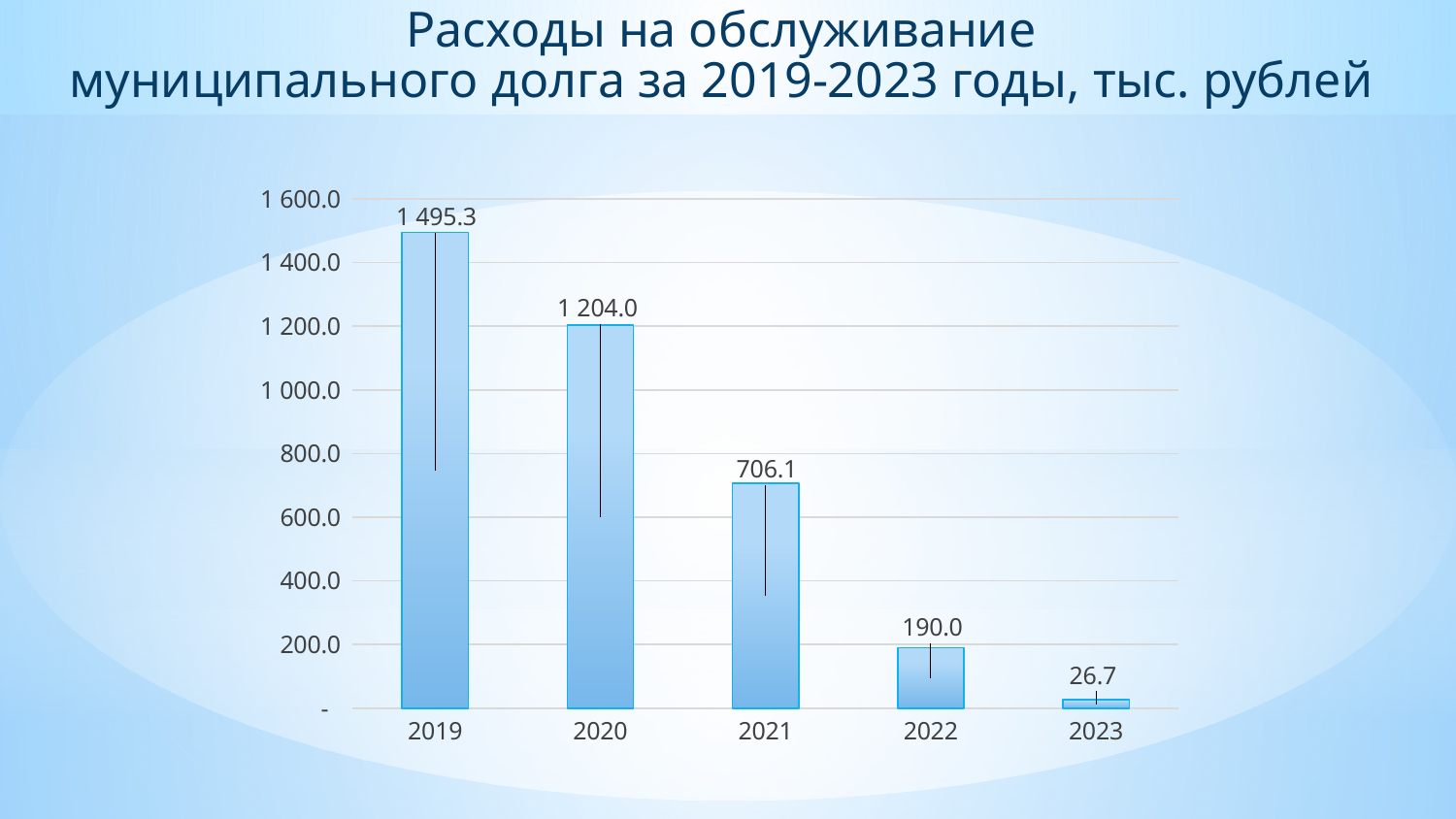
What is the value for 2021? 706.1 Which year has the lowest value? 2023 What kind of chart is shown on the slide? bar chart What is the difference between the values for 2019 and 2020? 291.3 What is the difference between the values for 2022 and 2023? 163.3 Which year has the highest value? 2019 Do the values rise or fall from 2019 to 2023? fall How many years are shown on the x axis? 5 What is the value for 2019? 1 495.3 Which is larger, the value for 2020 or the value for 2021? 2020 What is the value for 2023? 26.7 Is the value for 2022 greater or less than 400.0? less